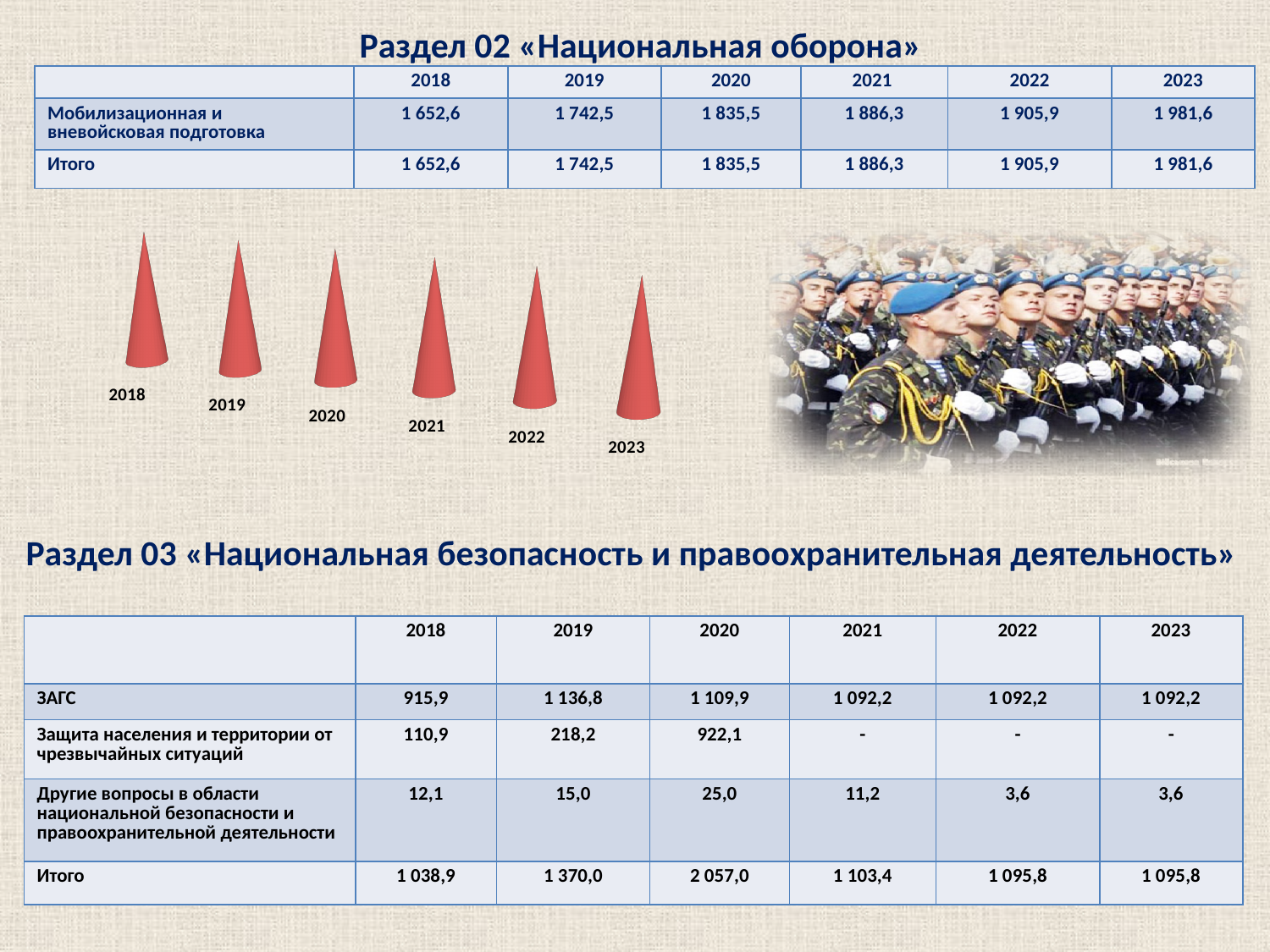
Which year has the highest value in the chart for Раздел 02 «Национальная оборона»? 2023 What is the value for 2020 in the chart for Раздел 02 «Национальная оборона»? 1 835,5 What colour are the bars in the chart? red What kind of chart is shown on the slide? bar chart Which year has the lowest value in the chart for Раздел 02 «Национальная оборона»? 2018 What is the value for 2018 in the chart for Раздел 02 «Национальная оборона»? 1 652,6 What is the value for 2023 in the chart for Раздел 02 «Национальная оборона»? 1 981,6 How many years (categories) does the chart show? 6 What is the difference between the 2023 and 2018 values in the chart for Раздел 02 «Национальная оборона»? 329,0 Do the values in the chart for Раздел 02 «Национальная оборона» rise or fall from 2018 to 2023? rise What is the first year label on the chart's x axis? 2018 Which is larger in the chart for Раздел 02 «Национальная оборона»: the value for 2019 or for 2021? 2021